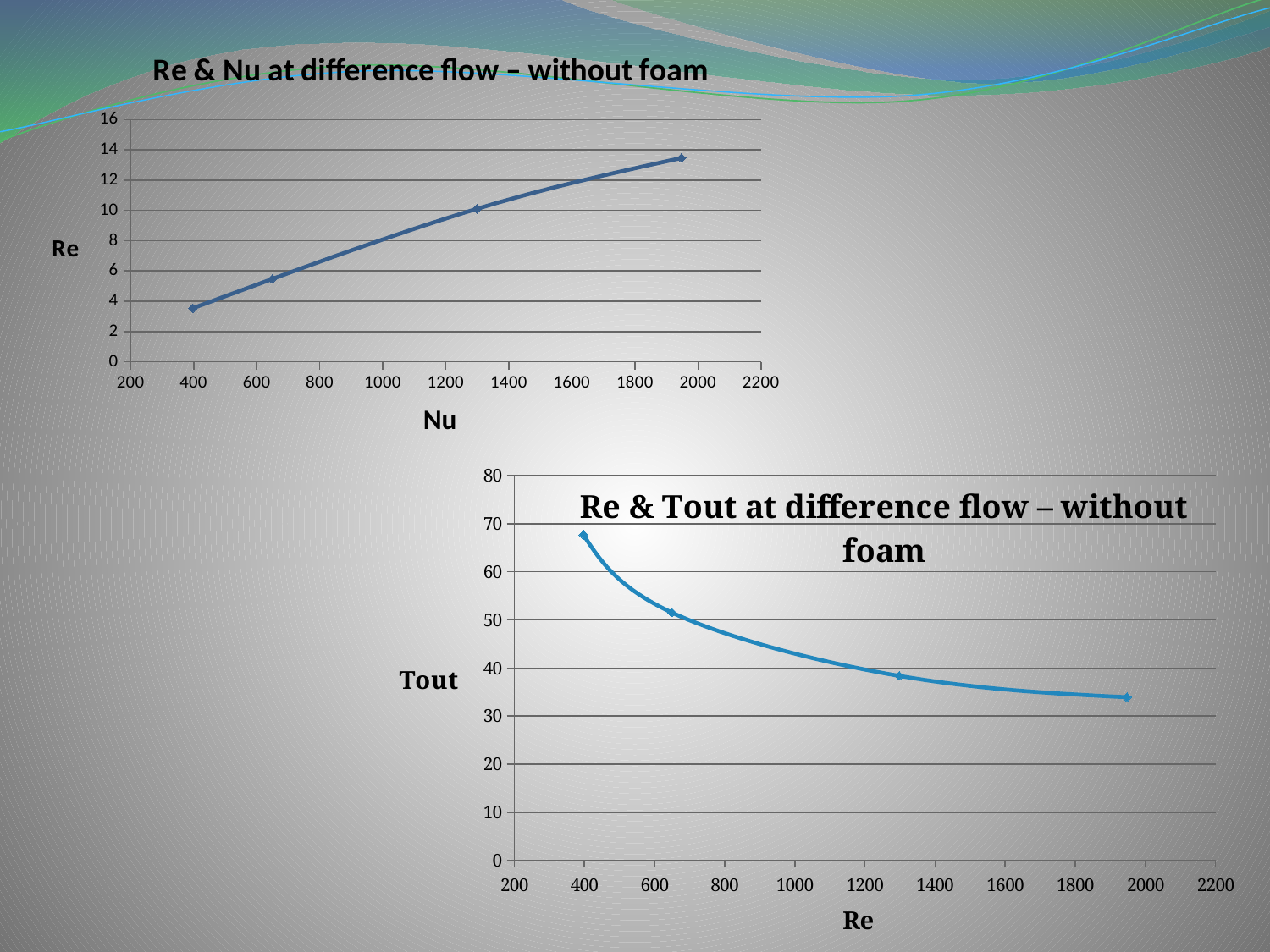
In the chart titled "Re & Tout at difference flow – without foam", is the value of the last (rightmost) point greater or less than 40? less In the chart titled "Re & Tout at difference flow – without foam", do the values rise or fall as you move along the x axis? fall In the chart titled "Re & Nu at difference flow – without foam", is the value of the last (rightmost) point greater or less than 12? greater In the chart titled "Re & Nu at difference flow – without foam", what is the label on the horizontal axis? Nu In the chart titled "Re & Tout at difference flow – without foam", what is the label on the vertical axis? Tout In the chart titled "Re & Tout at difference flow – without foam", is the value of the first (leftmost) point greater or less than 60? greater In the chart titled "Re & Nu at difference flow – without foam", what kind of chart is shown? line chart In the chart titled "Re & Nu at difference flow – without foam", do the values rise or fall as you move along the x axis? rise In the chart titled "Re & Tout at difference flow – without foam", what kind of chart is shown? line chart In the chart titled "Re & Nu at difference flow – without foam", how many data points are plotted? 4 In the chart titled "Re & Tout at difference flow – without foam", how many data points are plotted? 4